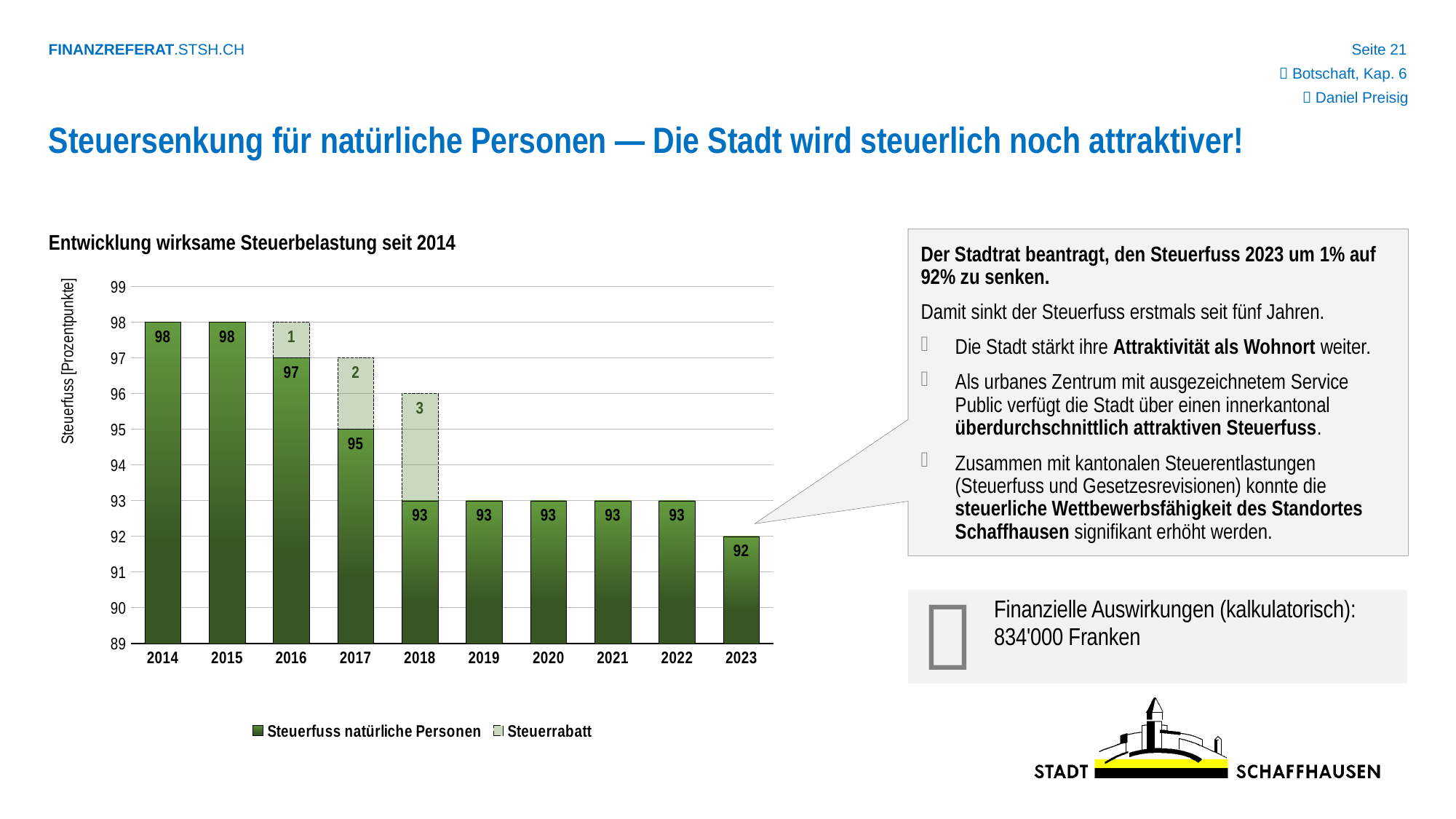
What is the Steuerrabatt value for 2018? 3 What is the value of Steuerfuss natürliche Personen for 2023? 92 Is the Steuerfuss natürliche Personen for 2016 larger or smaller than for 2019? larger What is the value of Steuerfuss natürliche Personen for 2014? 98 How many years are shown on the x axis? 10 Which year has the lowest Steuerfuss natürliche Personen? 2023 What is the difference between the Steuerfuss natürliche Personen in 2014 and in 2023? 6 What is the total height of the stacked bar for 2017 (Steuerfuss plus Steuerrabatt)? 97 How many series does the legend list? 2 Does the Steuerfuss natürliche Personen rise or fall from 2014 to 2023? fall What is the Steuerfuss natürliche Personen value for 2017? 95 What kind of chart is shown? bar chart